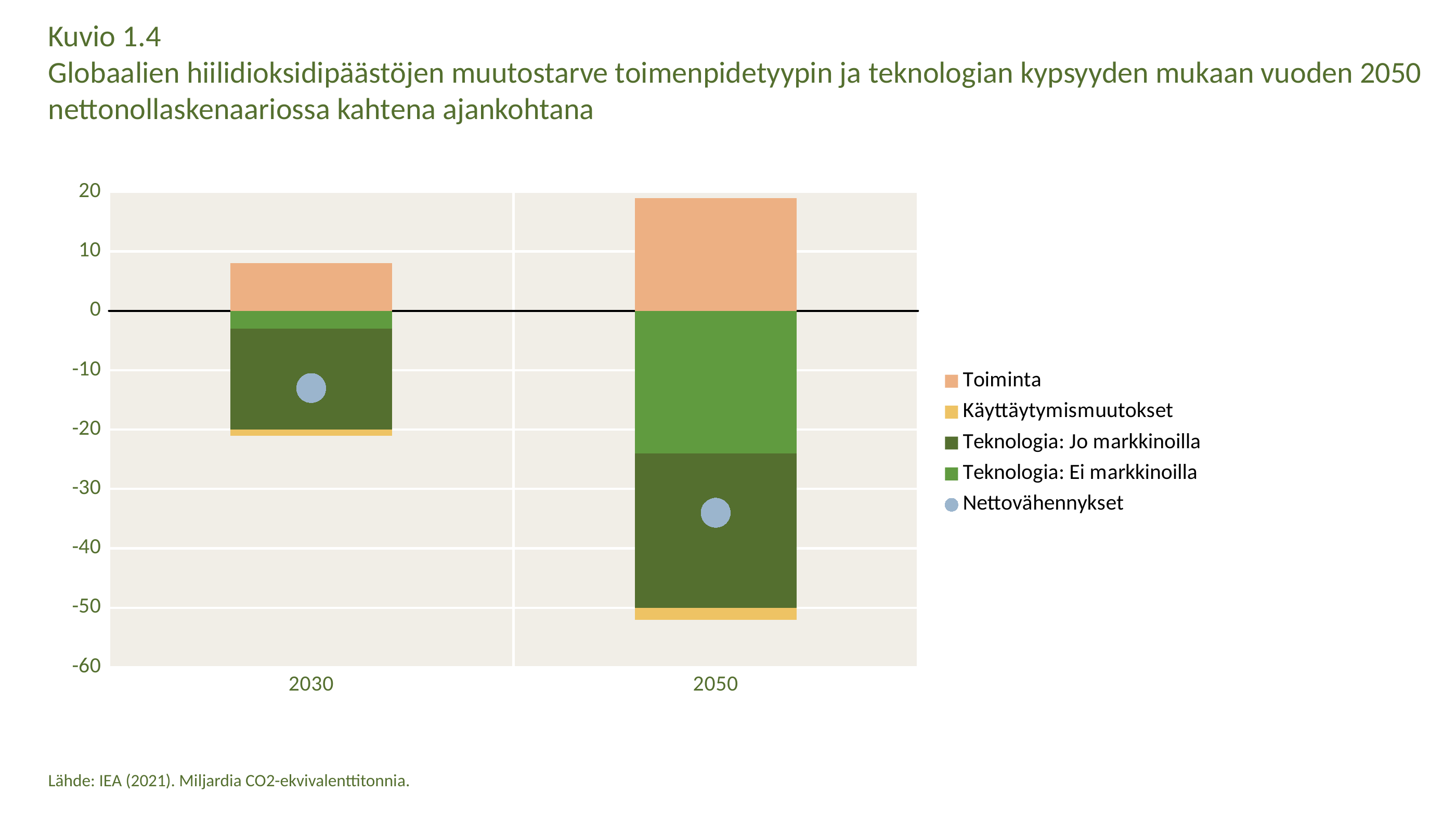
Is the Toiminta value for 2030 greater or less than 10? less What kind of chart is shown on the slide? Stacked bar chart with a point series Does the Nettovähennykset value rise or fall from 2030 to 2050? fall Which series is shown as a circle marker rather than a bar segment? Nettovähennykset Which year has the larger Toiminta value, 2030 or 2050? 2050 Which series is drawn in orange? Toiminta How many series does the legend list? 5 Is the Nettovähennykset value for 2030 greater or less than -10? less In which year is the Teknologia: Ei markkinoilla segment larger in size, 2030 or 2050? 2050 How many categories are shown on the x axis? 2 Is the Toiminta value for 2050 greater or less than 10? greater